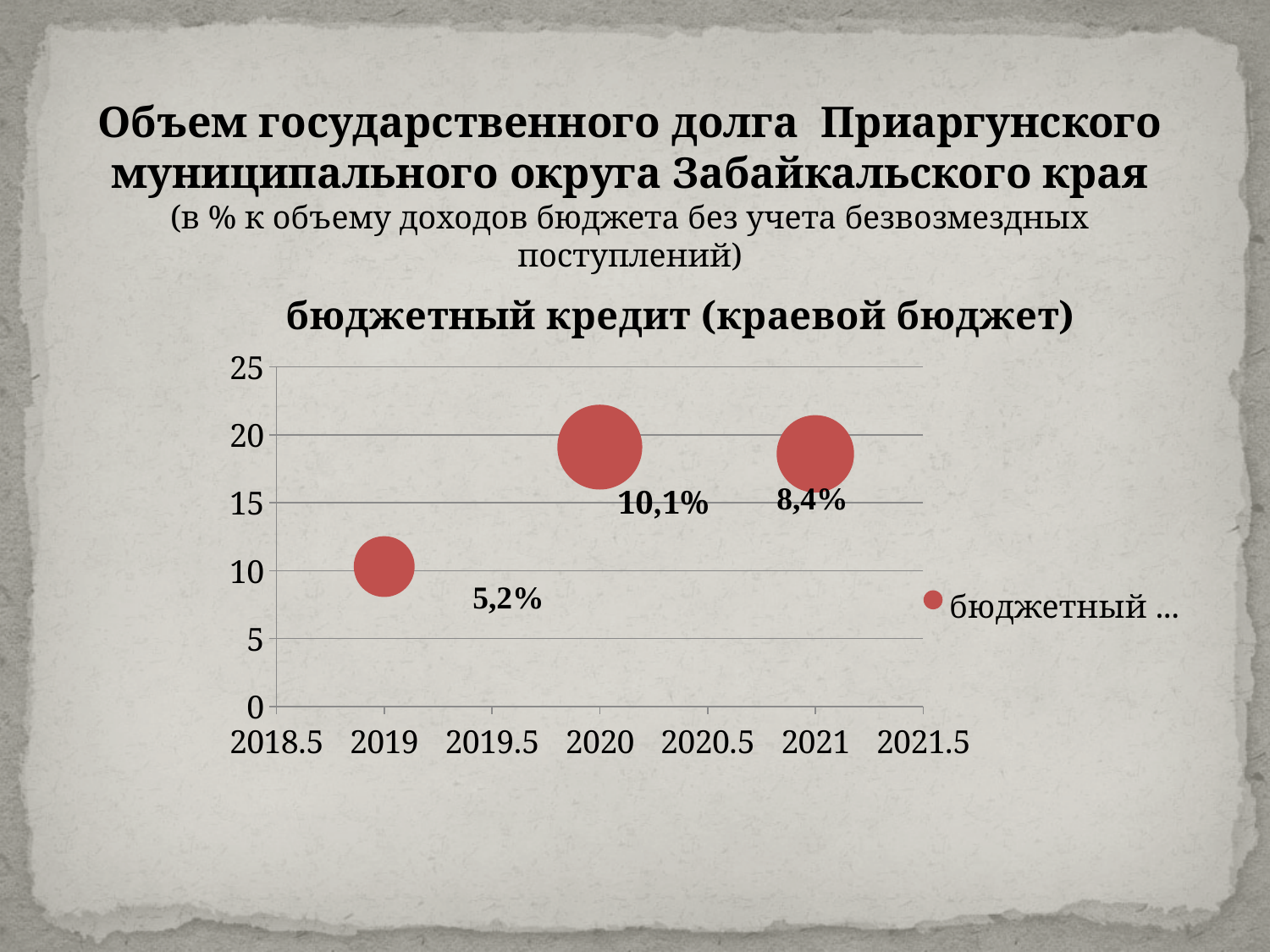
What is the labelled value for 2021? 8,4% What is the title of the chart? бюджетный кредит (краевой бюджет) What is the difference between the labelled values for 2020 and 2021? 1,7% Which year has the lowest labelled value? 2019 What is the labelled value for 2019? 5,2% Is the bubble for 2020 positioned greater or less than 15 on the vertical axis? greater Which year has the highest labelled value? 2020 What is the difference between the labelled values for 2020 and 2019? 4,9% What kind of chart is shown? bubble chart Which labelled value is larger, 2021 or 2019? 2021 What is the labelled value for 2020? 10,1% How many data points (bubbles) are plotted? 3